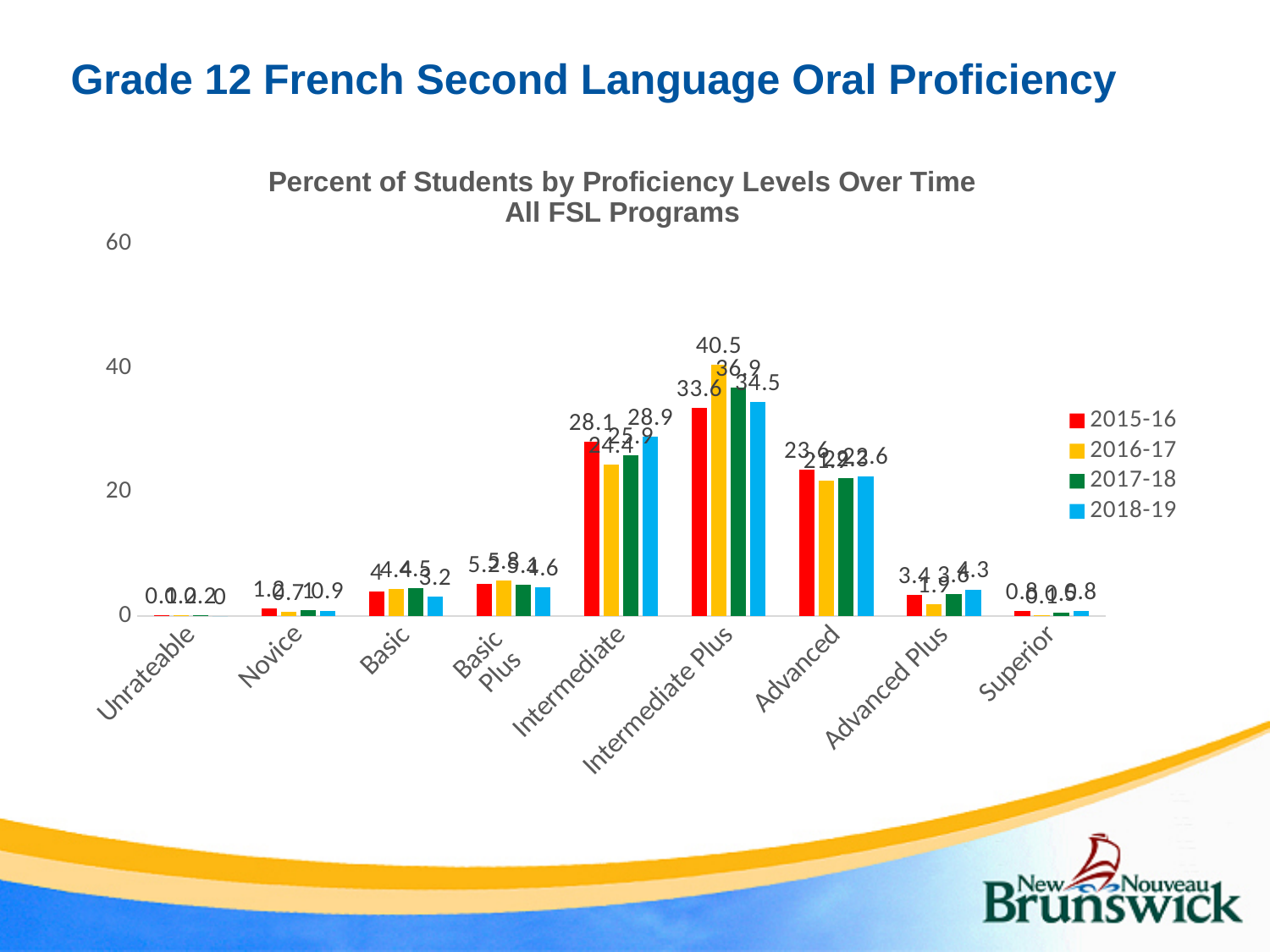
What is the value for 2016-17 at Intermediate Plus? 40.5 How many series does the legend list? 4 What is the title of the chart? Percent of Students by Proficiency Levels Over Time All FSL Programs What is the difference between the 2016-17 and 2015-16 values at Intermediate Plus? 6.9 Which proficiency level has the highest value for 2016-17? Intermediate Plus What kind of chart is shown on the slide? bar chart Which is larger at Intermediate Plus, the 2016-17 value or the 2017-18 value? 2016-17 Is the value for 2015-16 at Advanced greater or less than 20? greater What is the value for 2018-19 at Advanced Plus? 4.3 What is the value for 2018-19 at Intermediate? 28.9 What is the value for 2015-16 at Intermediate Plus? 33.6 How many proficiency level categories are shown on the x axis? 9